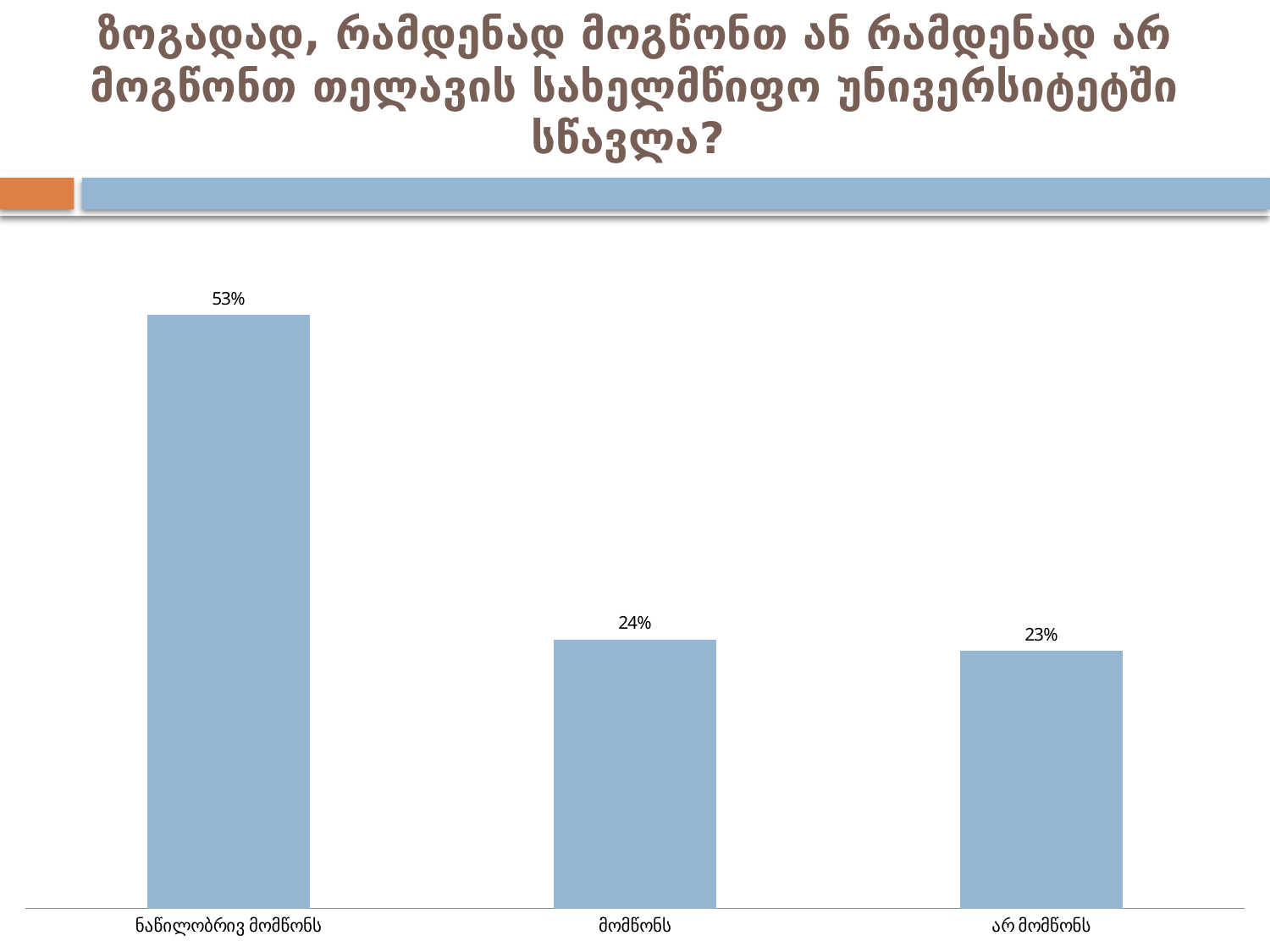
What is the value for არ მომწონს? 23% Which category has the highest value? ნაწილობრივ მომწონს What is the value for მომწონს? 24% What colour are the bars in the chart? light blue Do the values rise or fall from left to right across the categories? fall What is the value for ნაწილობრივ მომწონს? 53% What kind of chart is shown on the slide? bar chart Which category has the lowest value? არ მომწონს What is the difference between the values for ნაწილობრივ მომწონს and მომწონს? 29% How many categories are shown in the chart? 3 What is the difference between the values for მომწონს and არ მომწონს? 1% Which is larger, the value for ნაწილობრივ მომწონს or the value for არ მომწონს? ნაწილობრივ მომწონს